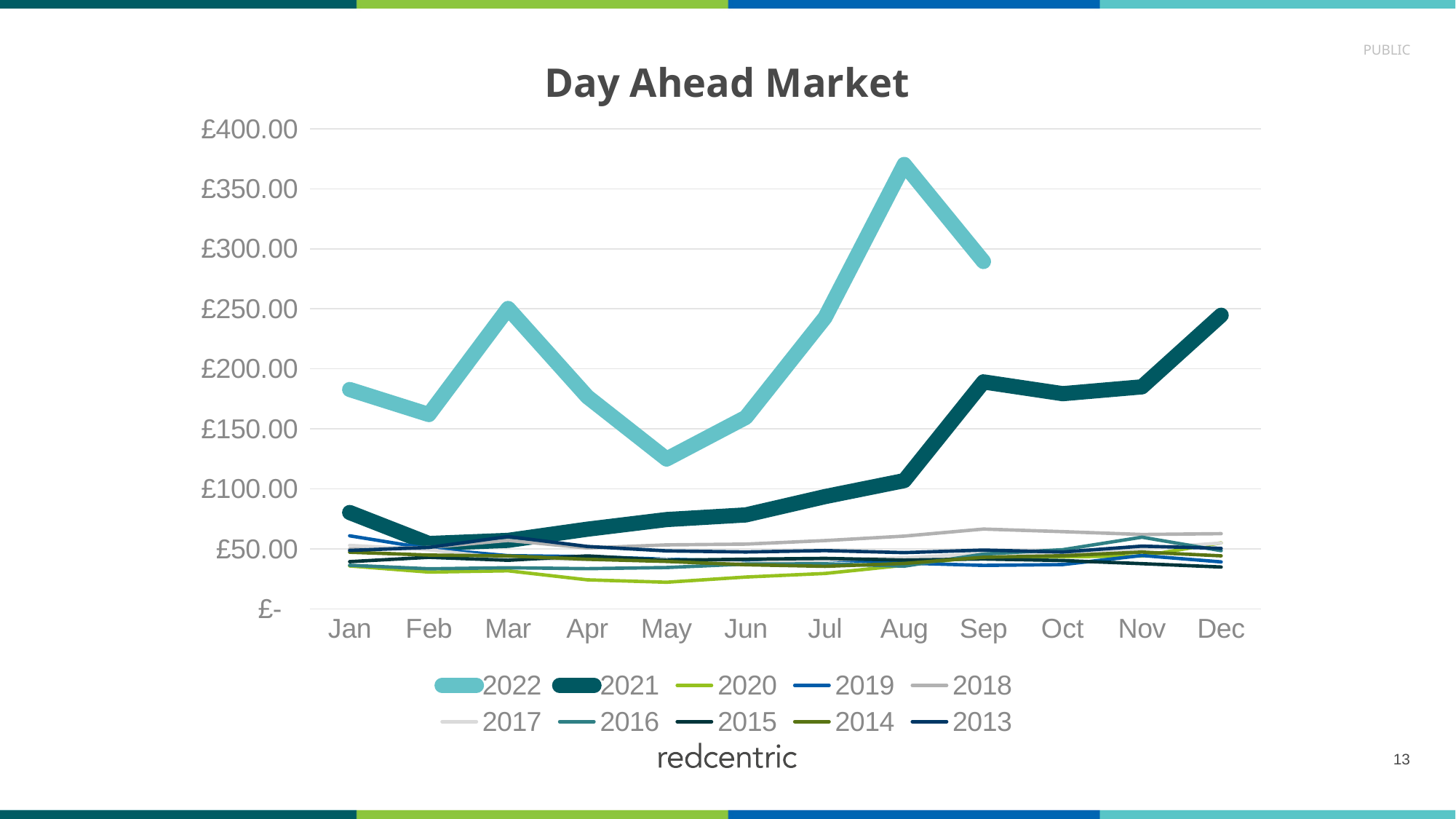
In which month does the 2022 series reach its lowest value? May Is the value for 2021 in Dec greater or less than £200.00? greater In which month does the 2021 series reach its highest value? Dec How many months are shown on the x axis? 12 How many series does the legend list? 10 Is the value for 2022 in Aug greater or less than £350.00? greater What is the title of the chart? Day Ahead Market Does the 2021 series rise or fall from May to Sep? rise In which month does the 2022 series reach its highest value? Aug What kind of chart is shown on the slide? line chart Is the value for 2020 in May greater or less than £50.00? less Which series has the larger value in Mar, 2022 or 2021? 2022